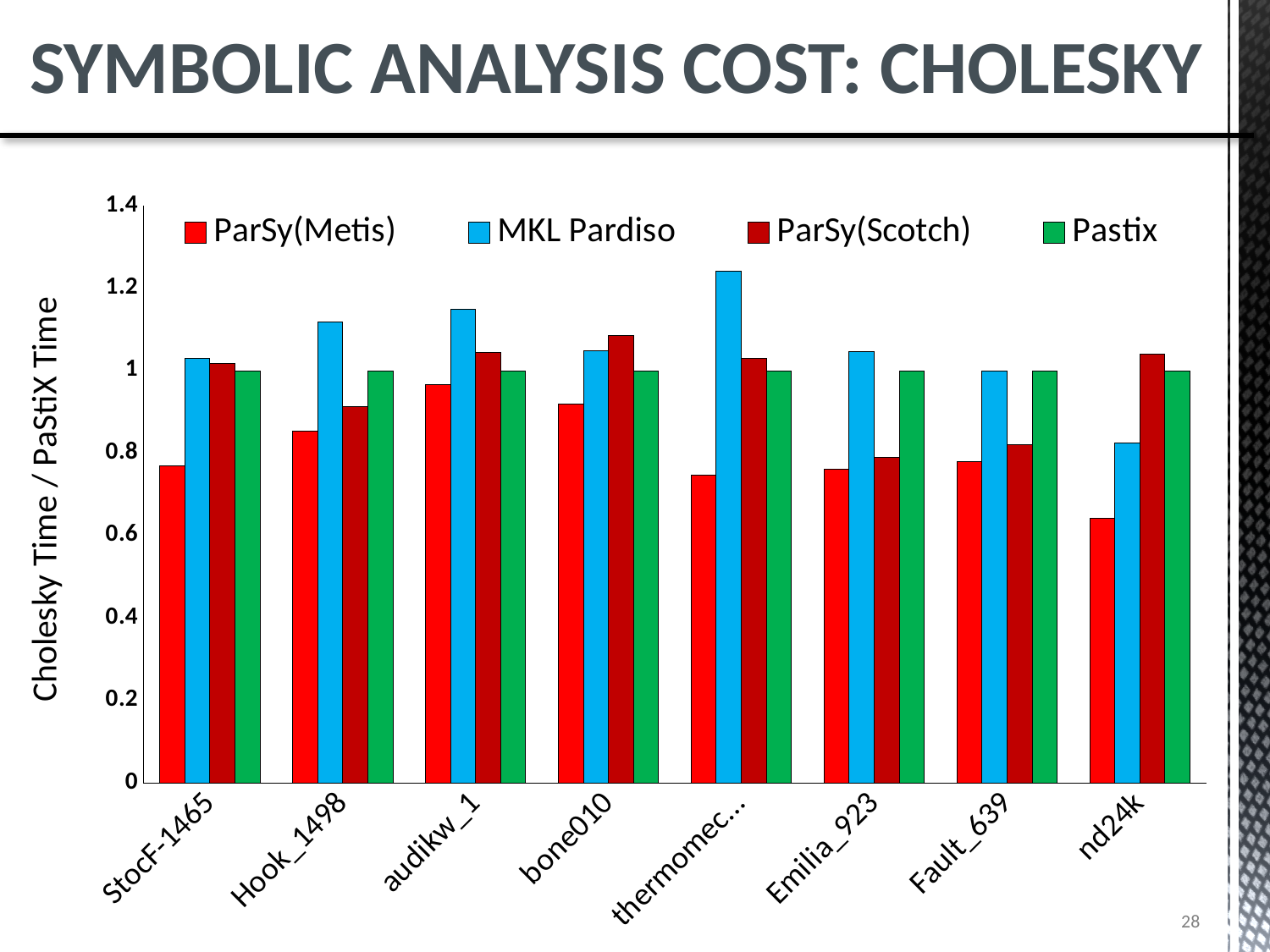
Which category has the highest MKL Pardiso bar? thermomec... Is the MKL Pardiso value for thermomec... greater or less than 1.2? greater How many series does the legend list? 4 What kind of chart is shown on the slide? bar chart Which category has the lowest ParSy(Metis) bar? nd24k Is the ParSy(Scotch) value for Hook_1498 greater or less than 1? less Is the MKL Pardiso value for Hook_1498 greater or less than 1? greater How many categories (matrices) are shown along the x axis? 8 For nd24k, which is larger: the ParSy(Scotch) value or the MKL Pardiso value? ParSy(Scotch) What is the label on the y axis of the chart? Cholesky Time / PaStiX Time For Hook_1498, which is larger: the MKL Pardiso value or the ParSy(Scotch) value? MKL Pardiso